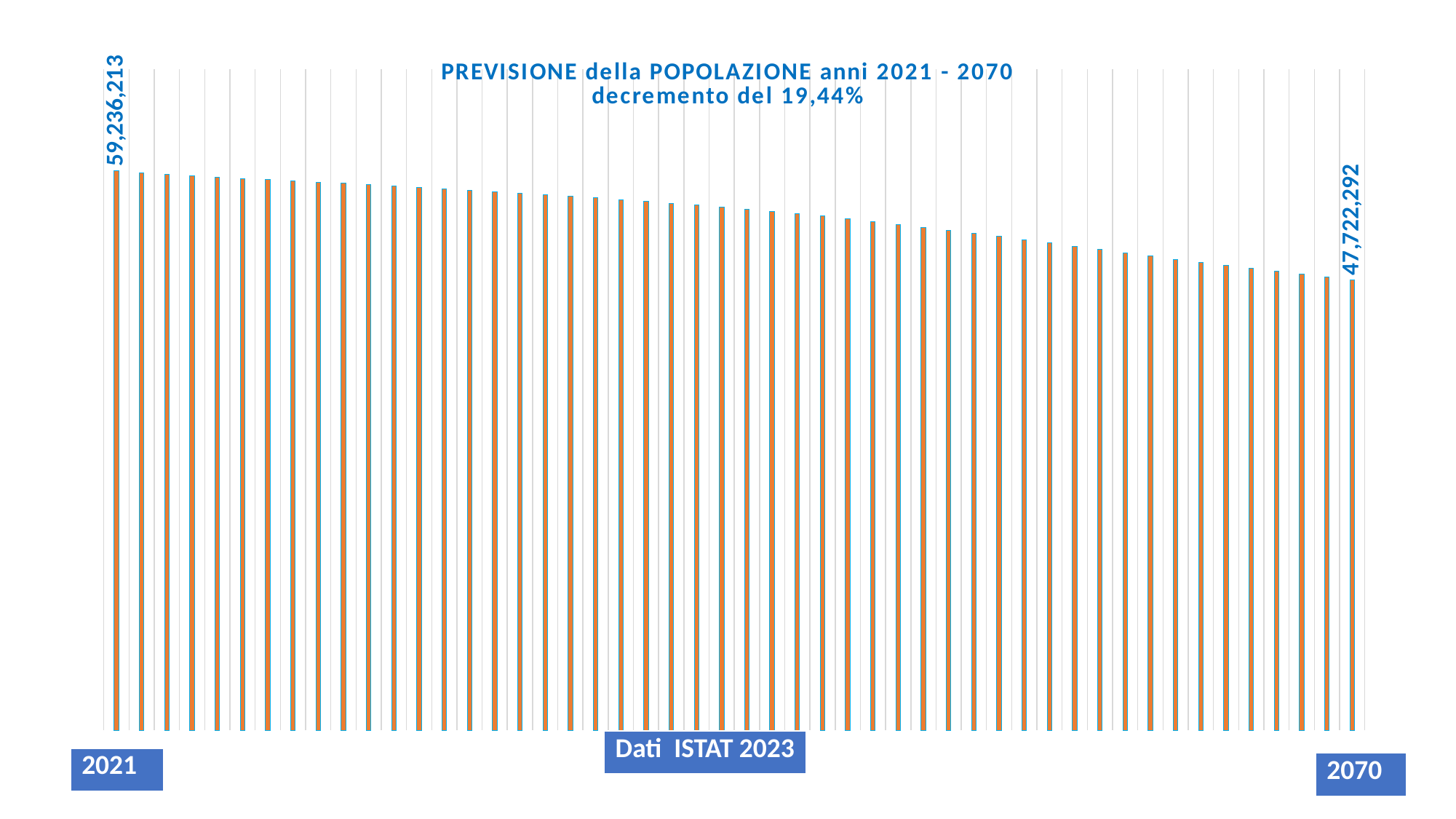
Which is larger, the population value for 2021 or for 2070? 2021 What data source is cited on the slide? Dati ISTAT 2023 Which year has the lowest population value in the chart? 2070 What kind of chart is shown on the slide? bar chart How many years (bars) are plotted in the chart? 50 What is the population value shown for 2070? 47,722,292 What is the difference between the population values for 2021 and 2070? 11,513,921 Do the population values rise or fall from 2021 to 2070? fall What percentage decrease is stated in the chart title? 19,44% What is the population value shown for 2021? 59,236,213